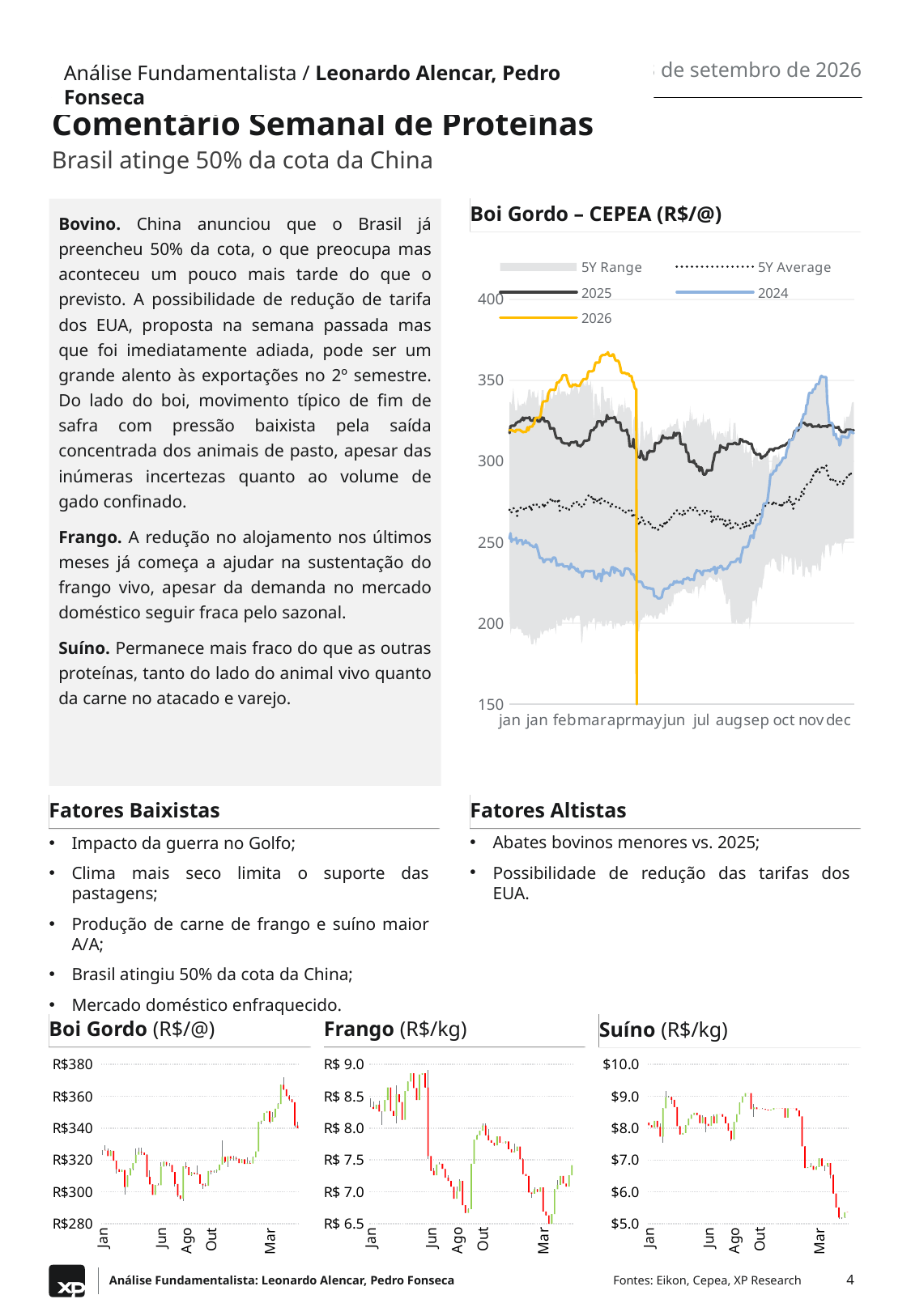
In the Boi Gordo – CEPEA (R$/@) chart, which series is higher in jan, 2025 or 2024? 2025 In the Boi Gordo – CEPEA (R$/@) chart, how many entries does the legend list? 5 In the Boi Gordo – CEPEA (R$/@) chart, is the peak value of the 2026 series greater or less than 350? greater In the Boi Gordo – CEPEA (R$/@) chart, is the value of the 2025 series in jan greater or less than 300? greater In the Boi Gordo – CEPEA (R$/@) chart, is the value of the 2024 series at the start of the year (jan) greater or less than 300? less In the Suíno (R$/kg) chart at the bottom right, does the price rise or fall from Out to Mar? fall In the Boi Gordo – CEPEA (R$/@) chart, does the 2024 series rise or fall between jan and may? fall In the Boi Gordo – CEPEA (R$/@) chart, which series is drawn in yellow? 2026 What is the title of the line chart at the top right of the slide? Boi Gordo – CEPEA (R$/@) What kind of chart is the Boi Gordo – CEPEA (R$/@) chart? line chart